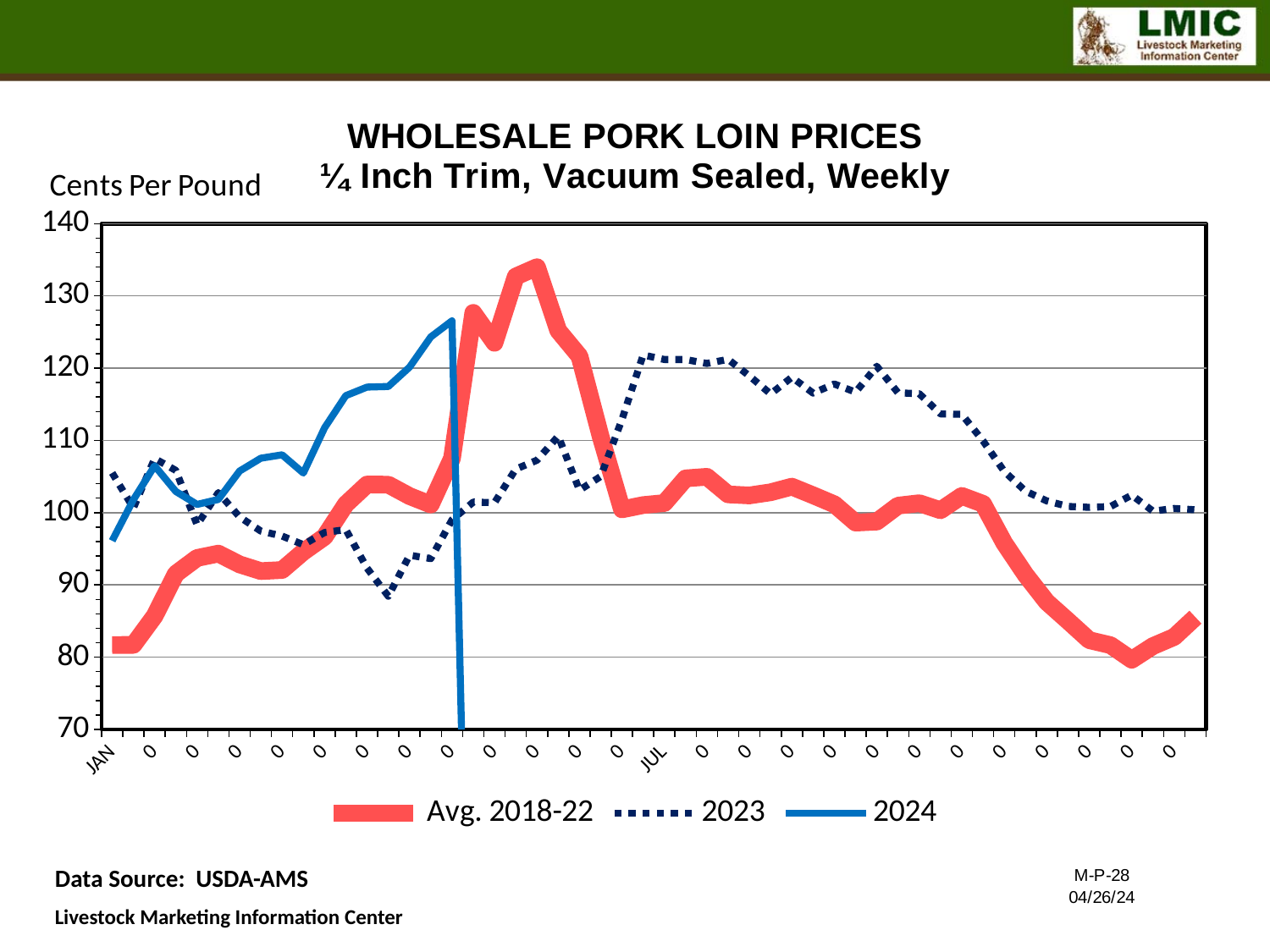
What are the three series named in the legend? Avg. 2018-22, 2023, 2024 What kind of chart is shown on the slide? line chart Is the value of the 2023 series at JUL greater or less than 110? greater Does the Avg. 2018-22 series generally rise or fall from JUL to the end of the year? fall How many series does the legend list? 3 At JAN, which series has the higher value, 2024 or Avg. 2018-22? 2024 Which series reaches the highest value anywhere on the chart? Avg. 2018-22 Is the peak value of the Avg. 2018-22 series greater or less than 130? greater Is the highest value reached by the 2024 series greater or less than 130? less What unit is shown on the vertical axis label? Cents Per Pound